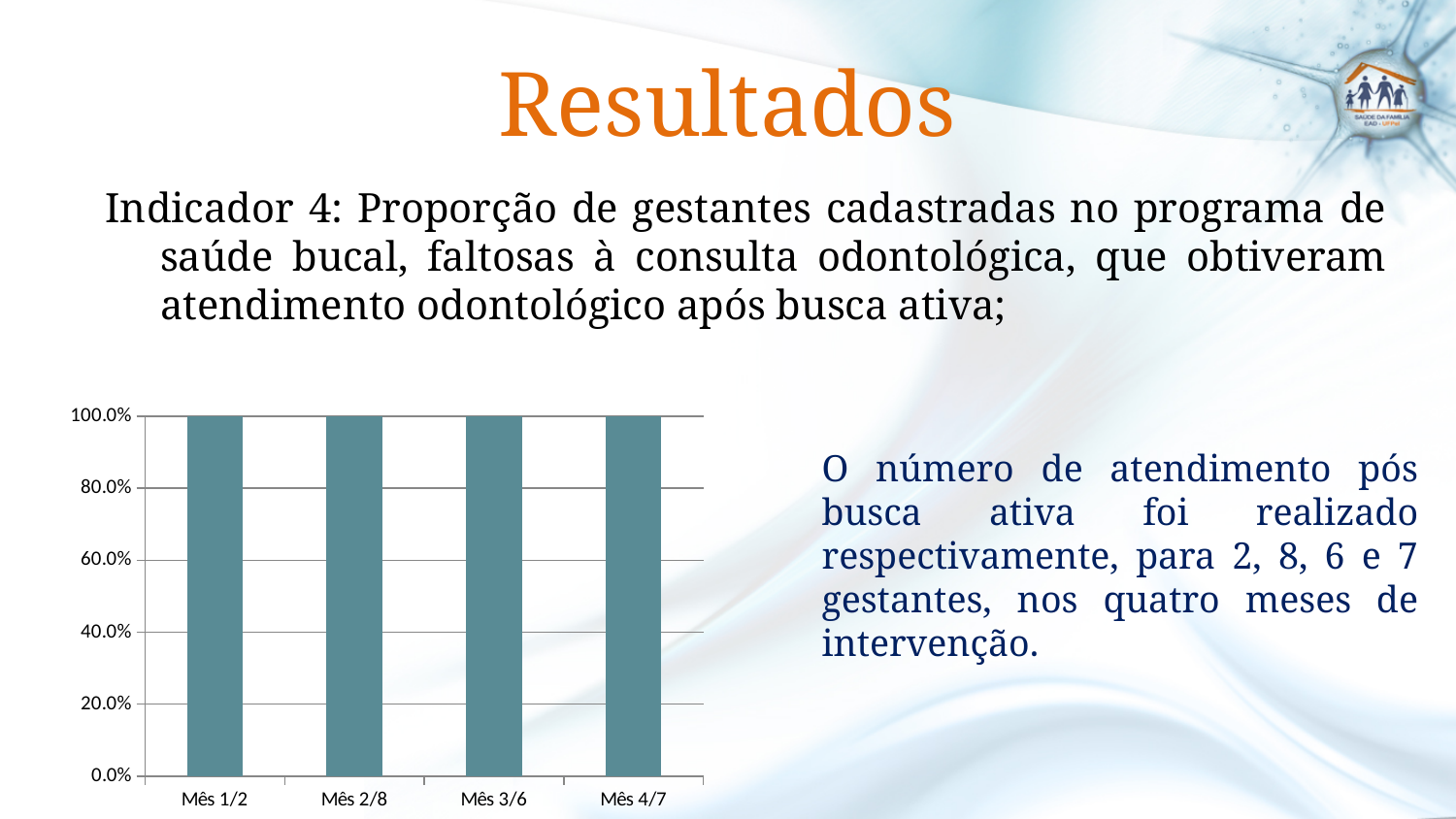
What is the value for Mês 1/2? 100.0% What is the difference between the values for Mês 1/2 and Mês 4/7? 0.0% What is the label of the first category on the x axis? Mês 1/2 What is the value for Mês 4/7? 100.0% How many categories are shown on the x axis of the chart? 4 Is the value for Mês 1/2 greater or less than 60.0%? greater What is the highest value shown on the y axis of the chart? 100.0% What is the value for Mês 3/6? 100.0% Is the value for Mês 3/6 greater or less than 80.0%? greater What kind of chart is shown on the slide? bar chart Do the values rise, fall or stay the same across the four months on the x axis? stay the same What is the value for Mês 2/8? 100.0%